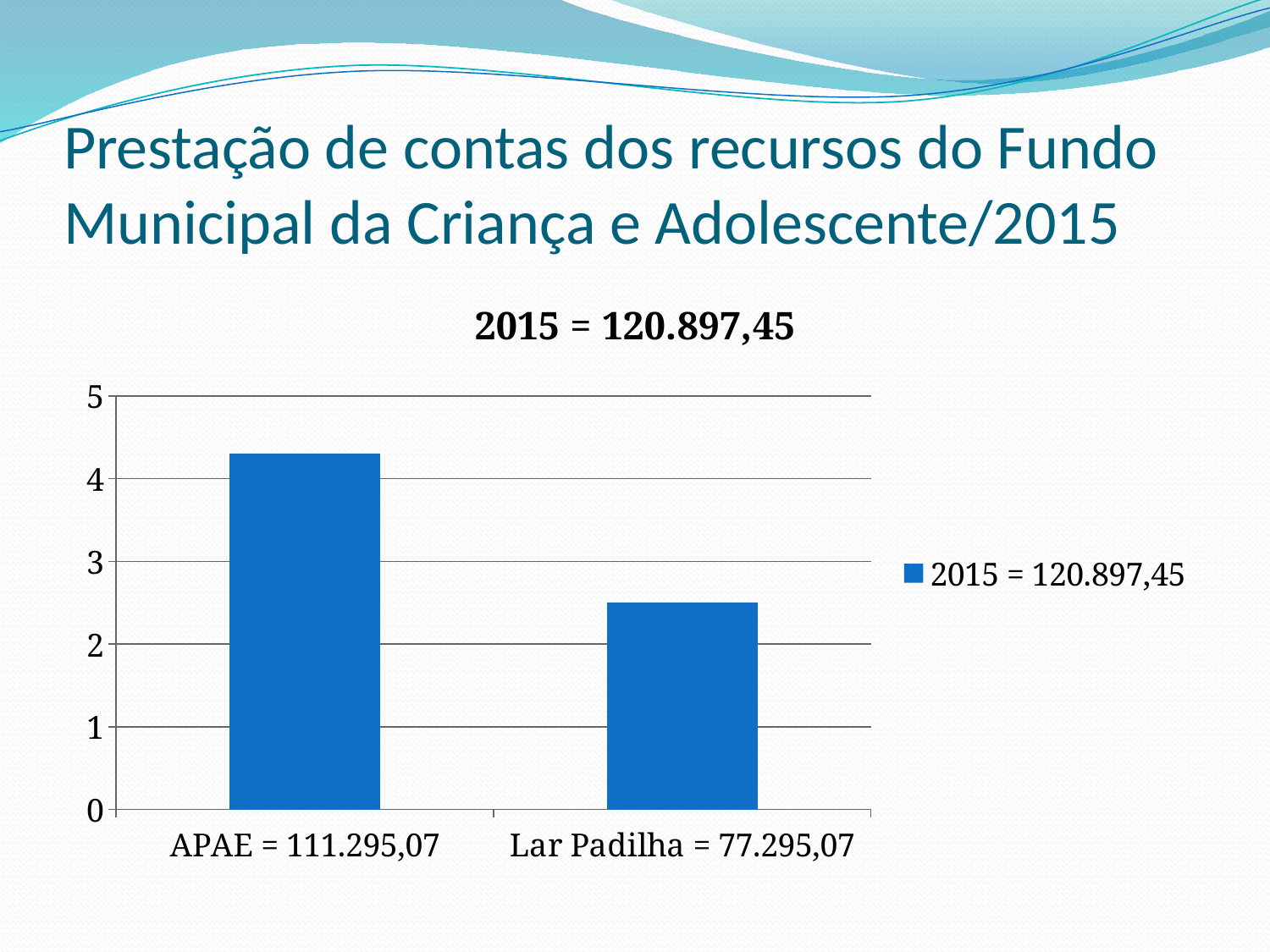
What kind of chart is shown on the slide? bar chart Is the value for Lar Padilha greater or less than 2? greater How many bars does the chart show? 2 What is the title of the chart? 2015 = 120.897,45 Which category has the lowest bar? Lar Padilha = 77.295,07 What is the legend entry shown on the chart? 2015 = 120.897,45 Is the value for APAE greater or less than 5? less Is the value for APAE greater or less than 4? greater Which bar is taller, APAE or Lar Padilha? APAE How many series does the legend list? 1 Which category has the highest bar? APAE = 111.295,07